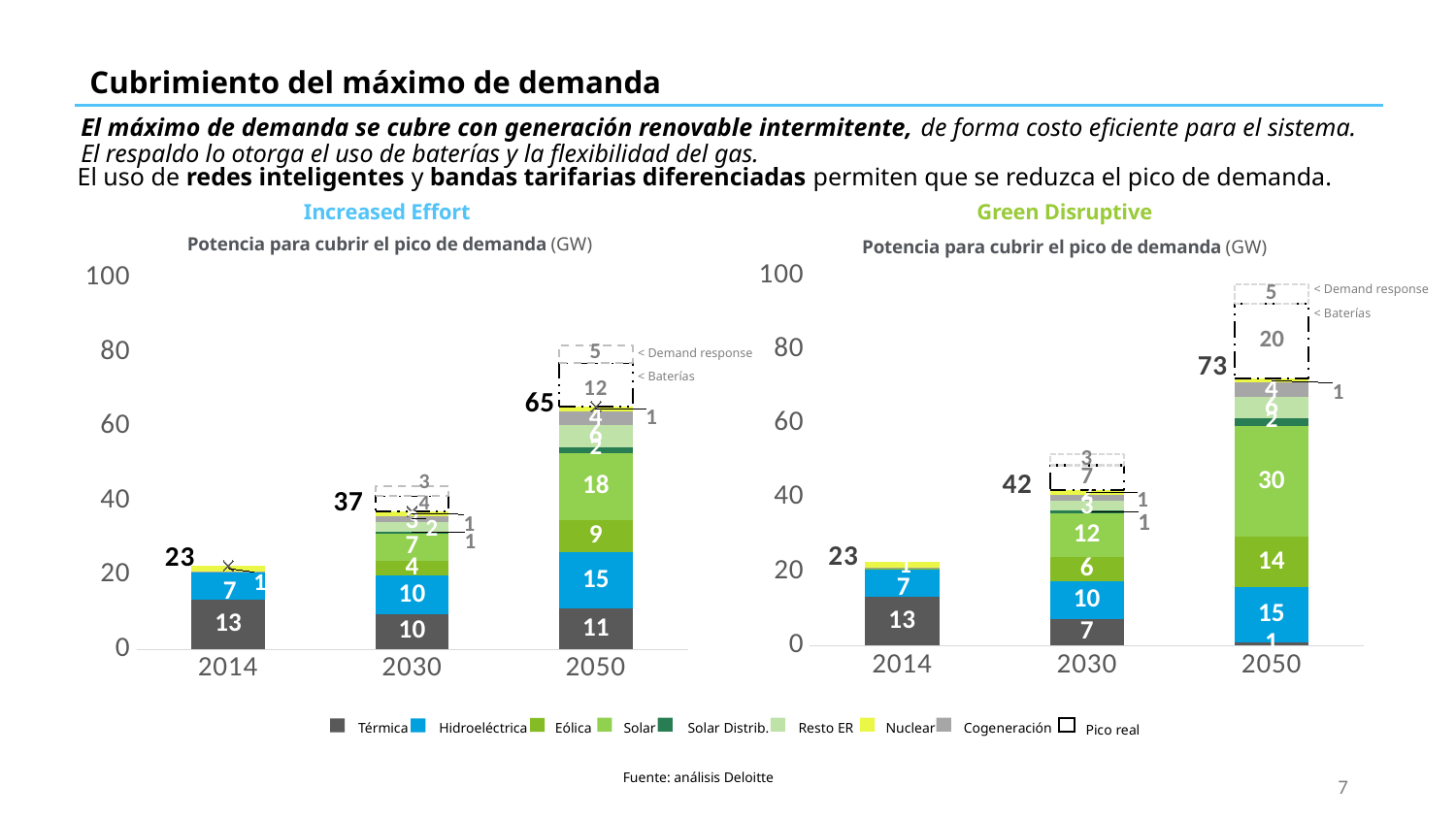
In the Green Disruptive chart, what is the Baterías value shown above the 2050 bar? 20 In the Increased Effort chart, what is the Demand response value shown above the 2050 bar? 5 What is the difference between the 2050 totals of the Green Disruptive chart (73) and the Increased Effort chart (65)? 8 In the Increased Effort chart, what is the total peak-demand capacity (Pico real) shown for 2050? 65 In the Green Disruptive chart, what is the Térmica value for 2030? 7 In the Increased Effort chart, what is the Solar value for 2050? 18 What kind of chart is used in the Increased Effort panel? Stacked bar chart How many years (categories) are shown on the x axis of the Green Disruptive chart? 3 Which chart shows a larger Solar value for 2050, Increased Effort or Green Disruptive? Green Disruptive In the Green Disruptive chart, what is the difference between the 2050 total (73) and the 2014 total (23)? 50 In the Increased Effort chart, which year has the highest total peak-demand capacity? 2050 In the Green Disruptive chart, what is the total peak-demand capacity (Pico real) shown for 2050? 73